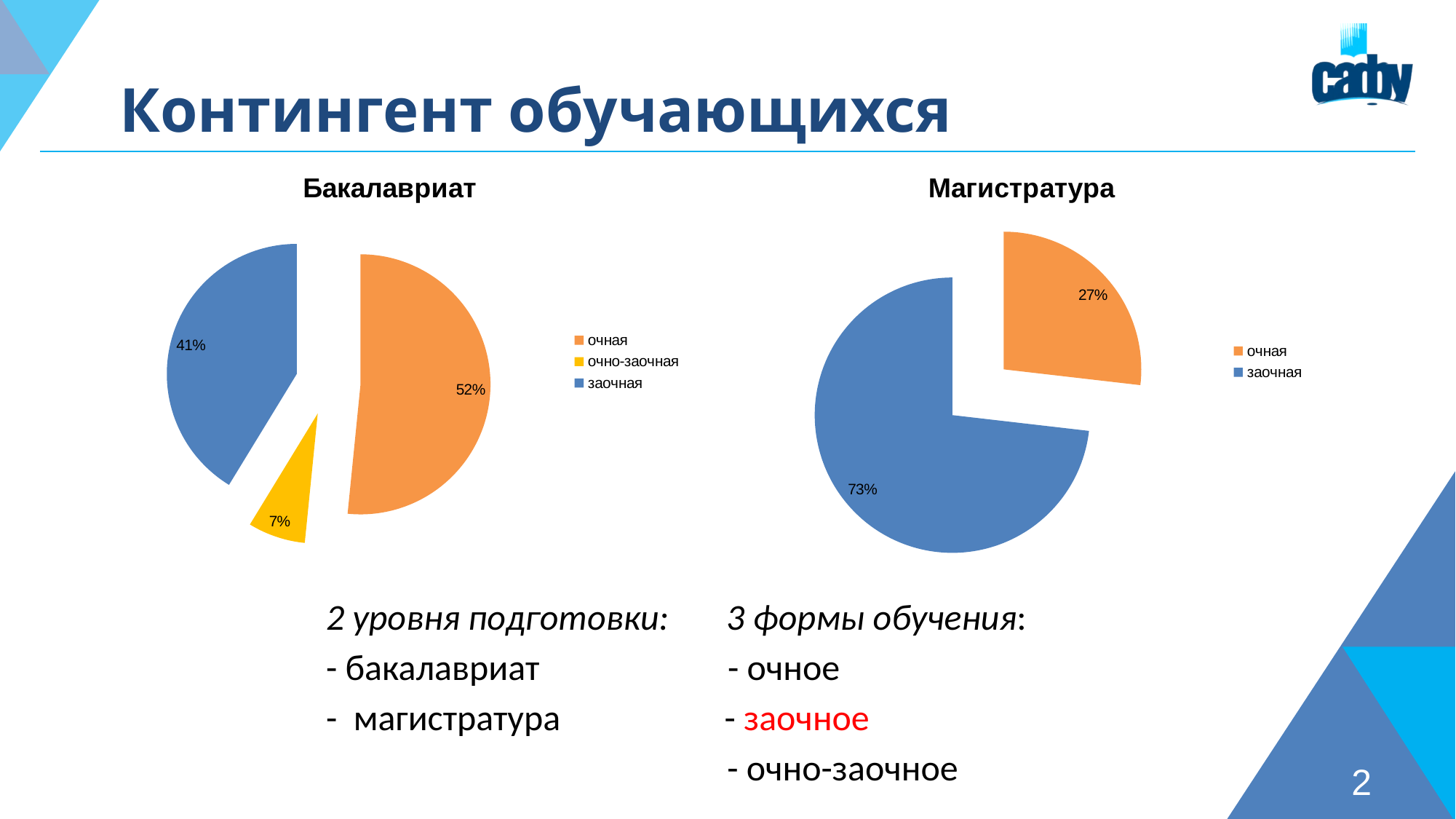
In the "Бакалавриат" chart, what share is shown for заочная? 41% How many categories does the legend of the "Бакалавриат" chart list? 3 What type of chart is the "Магистратура" chart? Pie chart In the "Бакалавриат" chart, which category has the smallest slice? очно-заочная In the "Бакалавриат" chart, what share is shown for очная? 52% In the "Бакалавриат" chart, what is the difference between the очная and заочная shares? 11% In the "Магистратура" chart, what is the difference between the заочная and очная shares? 46% In the "Бакалавриат" chart, what share is shown for очно-заочная? 7% In the "Бакалавриат" chart, which category has the largest slice? очная In the "Магистратура" chart, which category has the largest slice? заочная In the "Магистратура" chart, what share is shown for заочная? 73% In the "Магистратура" chart, what share is shown for очная? 27%